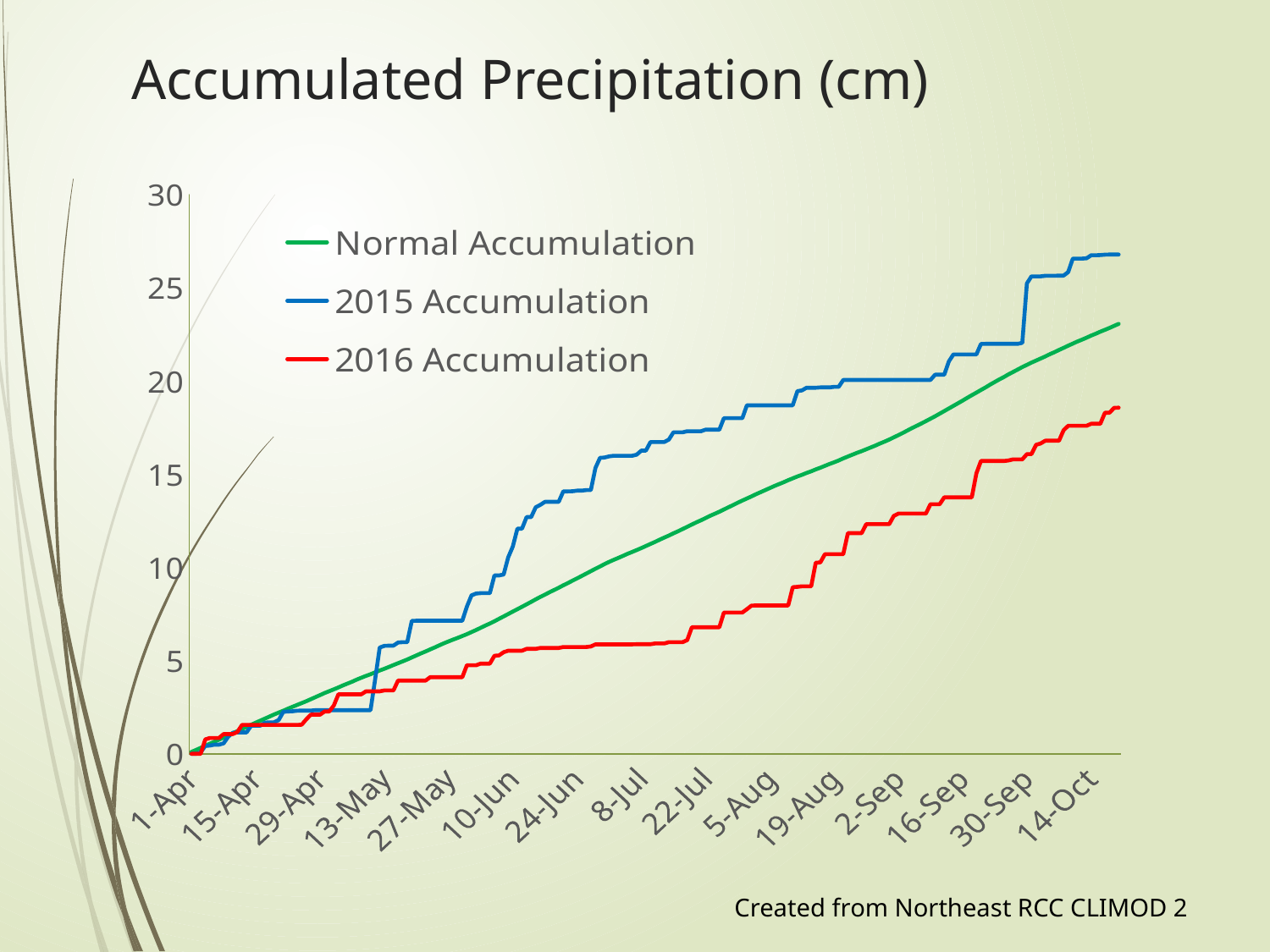
At 22-Jul, which is larger: Normal Accumulation or 2016 Accumulation? Normal Accumulation Is the 2016 Accumulation value at 14-Oct greater or less than 20? less Do the accumulation values rise or fall from 1-Apr to 14-Oct? rise Which series reaches the highest value at the end of the period (14-Oct)? 2015 Accumulation Which series has the lowest value at 14-Oct? 2016 Accumulation Is the 2015 Accumulation value at 10-Jun greater or less than 10? greater Is the Normal Accumulation value at 14-Oct greater or less than 20? greater How many series does the legend list? 3 Which colour is used for the 2016 Accumulation line? red What kind of chart is shown on the slide? line chart What is the title of the chart? Accumulated Precipitation (cm)